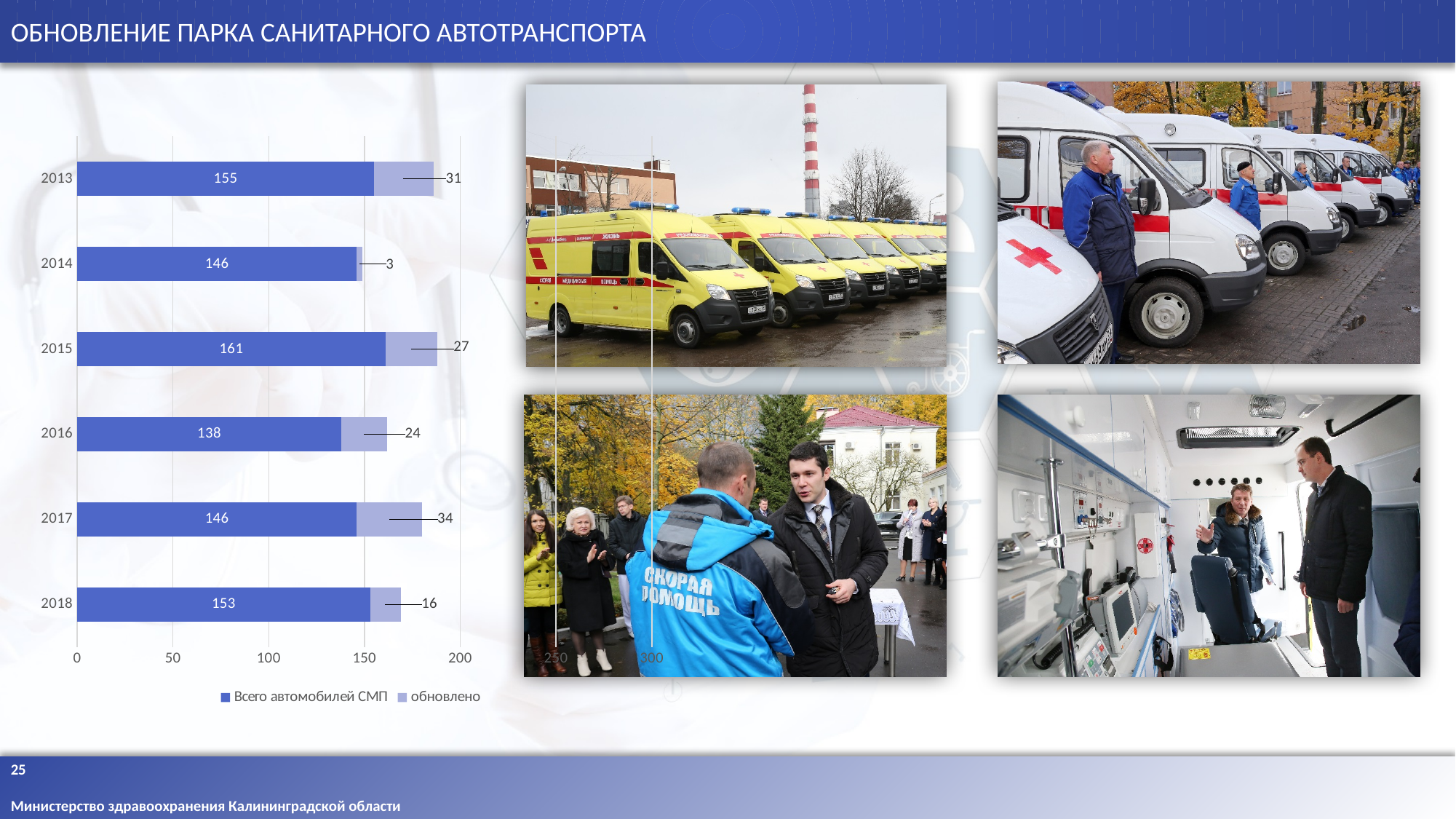
What kind of chart is shown on the slide? Stacked bar chart Which year has the lowest value for "обновлено"? 2014 What is the value of "Всего автомобилей СМП" for 2015? 161 Which year has the highest value for "Всего автомобилей СМП"? 2015 How many years are shown on the chart? 6 What is the total of the stacked bar for 2018? 169 What is the value of "обновлено" for 2017? 34 What are the two series listed in the legend? Всего автомобилей СМП and обновлено What is the difference between the "Всего автомобилей СМП" values for 2015 and 2016? 23 How many series does the legend list? 2 What is the value of "обновлено" for 2014? 3 Which is larger, the "обновлено" value for 2013 or for 2018? 2013